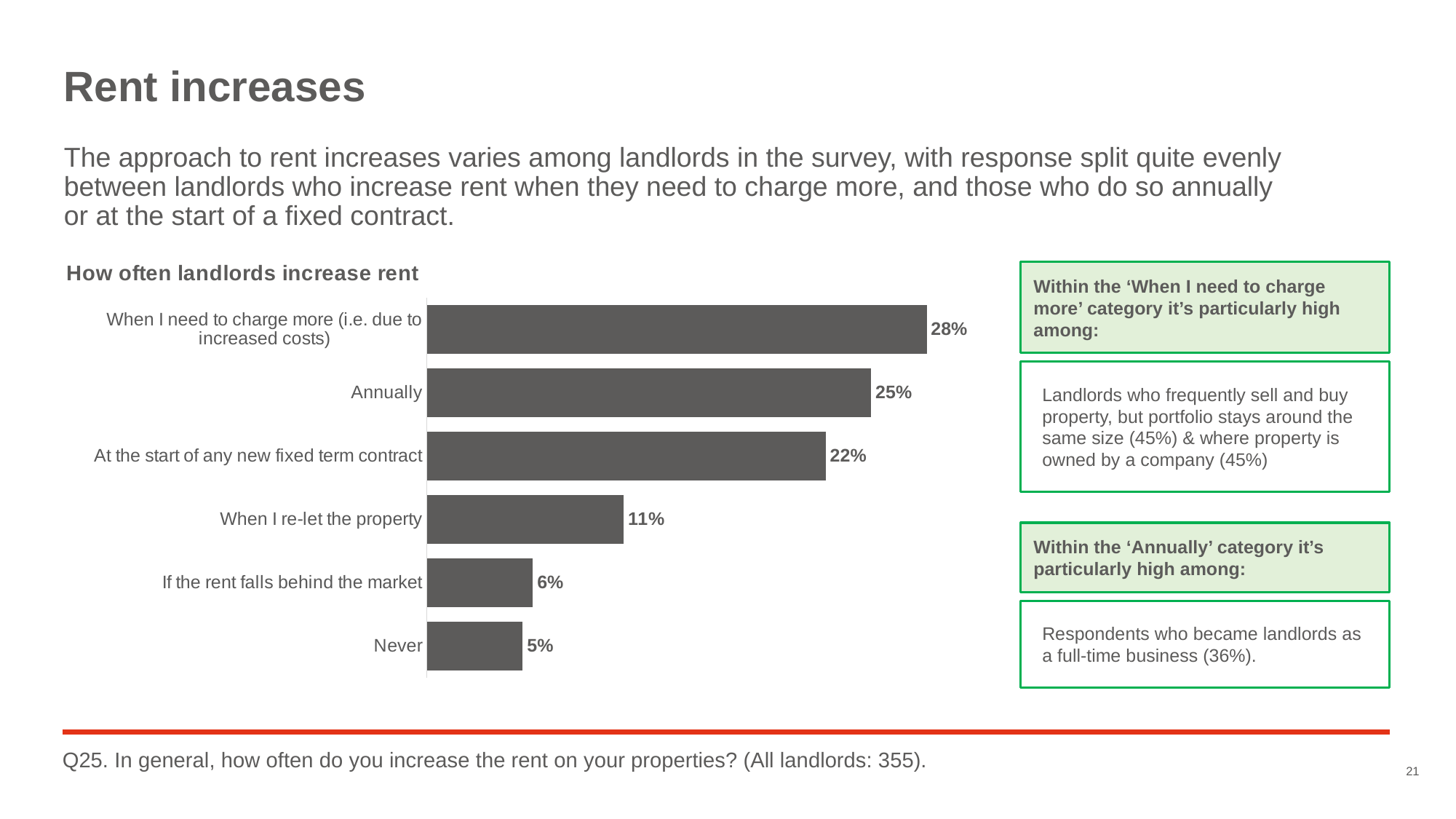
What type of chart is used to show how often landlords increase rent? Bar chart How many categories are shown in the chart? 6 Which is larger: the percentage for 'If the rent falls behind the market' or for 'Never'? If the rent falls behind the market Which category has the lowest percentage in the chart? Never Which category has the highest percentage in the chart? When I need to charge more (i.e. due to increased costs) What percentage of landlords never increase rent? 5% What percentage of landlords increase rent when they need to charge more (i.e. due to increased costs)? 28% What percentage of landlords increase rent annually? 25% What percentage of landlords increase rent at the start of any new fixed term contract? 22% What is the title of the chart? How often landlords increase rent What is the difference in percentage points between 'Annually' and 'When I re-let the property'? 14 What percentage of landlords increase rent when they re-let the property? 11%